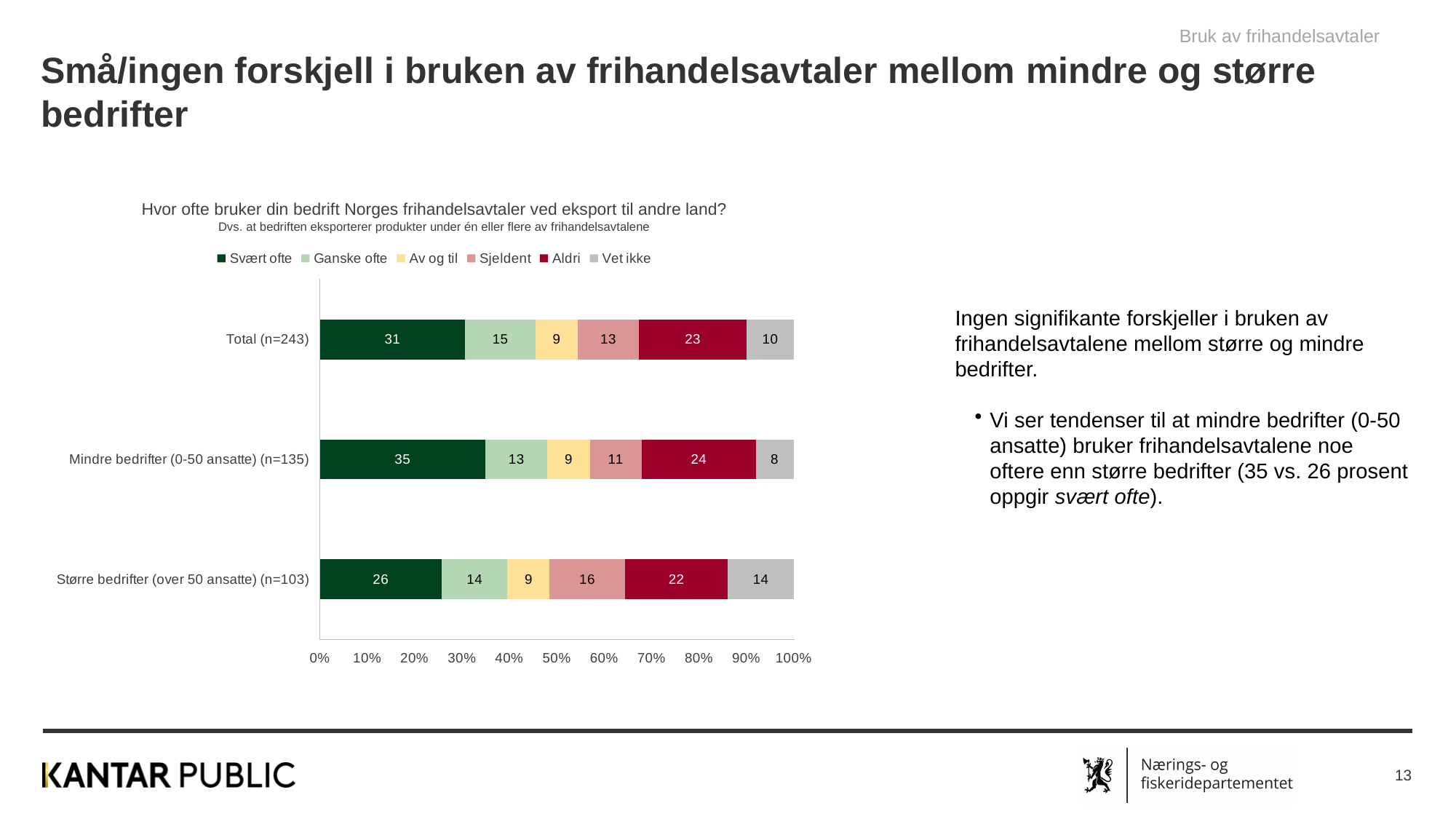
What is the total of the stacked bar for Mindre bedrifter (0-50 ansatte) (n=135)? 100 How many categories (bars) are plotted in the chart? 3 Which category has the highest value for 'Svært ofte'? Mindre bedrifter (0-50 ansatte) (n=135) Which category has the lowest value for 'Vet ikke'? Mindre bedrifter (0-50 ansatte) (n=135) What is the value for 'Vet ikke' for Større bedrifter (over 50 ansatte) (n=103)? 14 What kind of chart is shown on the slide? Stacked bar chart What is the difference between the 'Svært ofte' values for Mindre bedrifter (0-50 ansatte) and Større bedrifter (over 50 ansatte)? 9 How many series does the legend list? 6 What is the value for 'Aldri' for Total (n=243)? 23 What is the value for 'Svært ofte' for Mindre bedrifter (0-50 ansatte) (n=135)? 35 Which legend entry is shown in the darkest green colour? Svært ofte Which is larger: the 'Sjeldent' value for Større bedrifter (over 50 ansatte) or for Mindre bedrifter (0-50 ansatte)? Større bedrifter (over 50 ansatte)